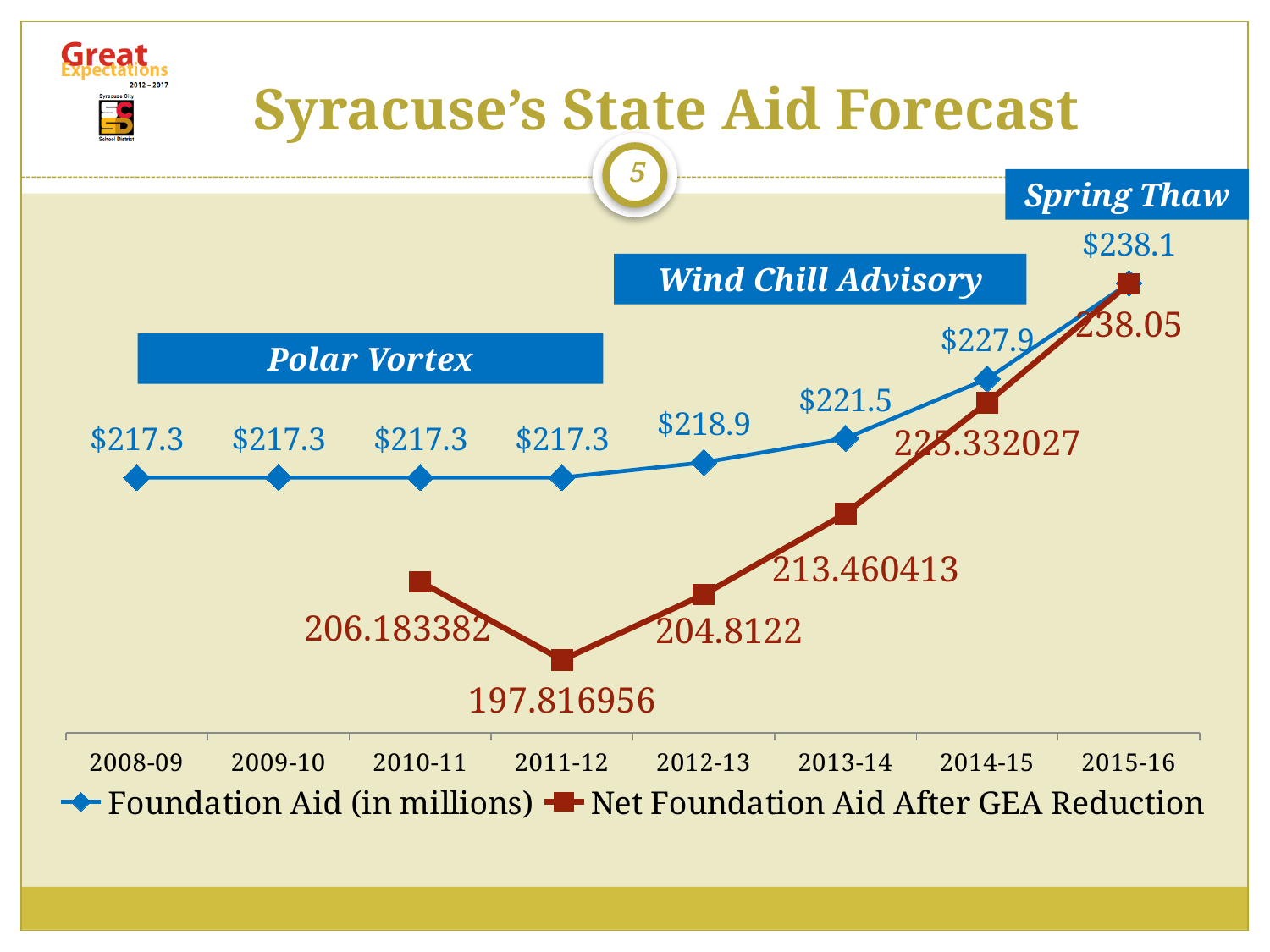
How many school years are shown on the x axis? 8 What is the Foundation Aid value for 2015-16? $238.1 What type of chart is shown on the slide? line chart How many series does the legend list? 2 What is the difference between Foundation Aid in 2015-16 and Foundation Aid in 2014-15? $10.2 In which year is Foundation Aid highest? 2015-16 What is the Net Foundation Aid After GEA Reduction value for 2013-14? 213.460413 Does Foundation Aid rise or fall from 2011-12 to 2015-16? rise In which year is the Net Foundation Aid After GEA Reduction lowest? 2011-12 What is the Net Foundation Aid After GEA Reduction value for 2011-12? 197.816956 Which is larger in 2012-13: Foundation Aid or Net Foundation Aid After GEA Reduction? Foundation Aid What is the Foundation Aid value for 2013-14? $221.5